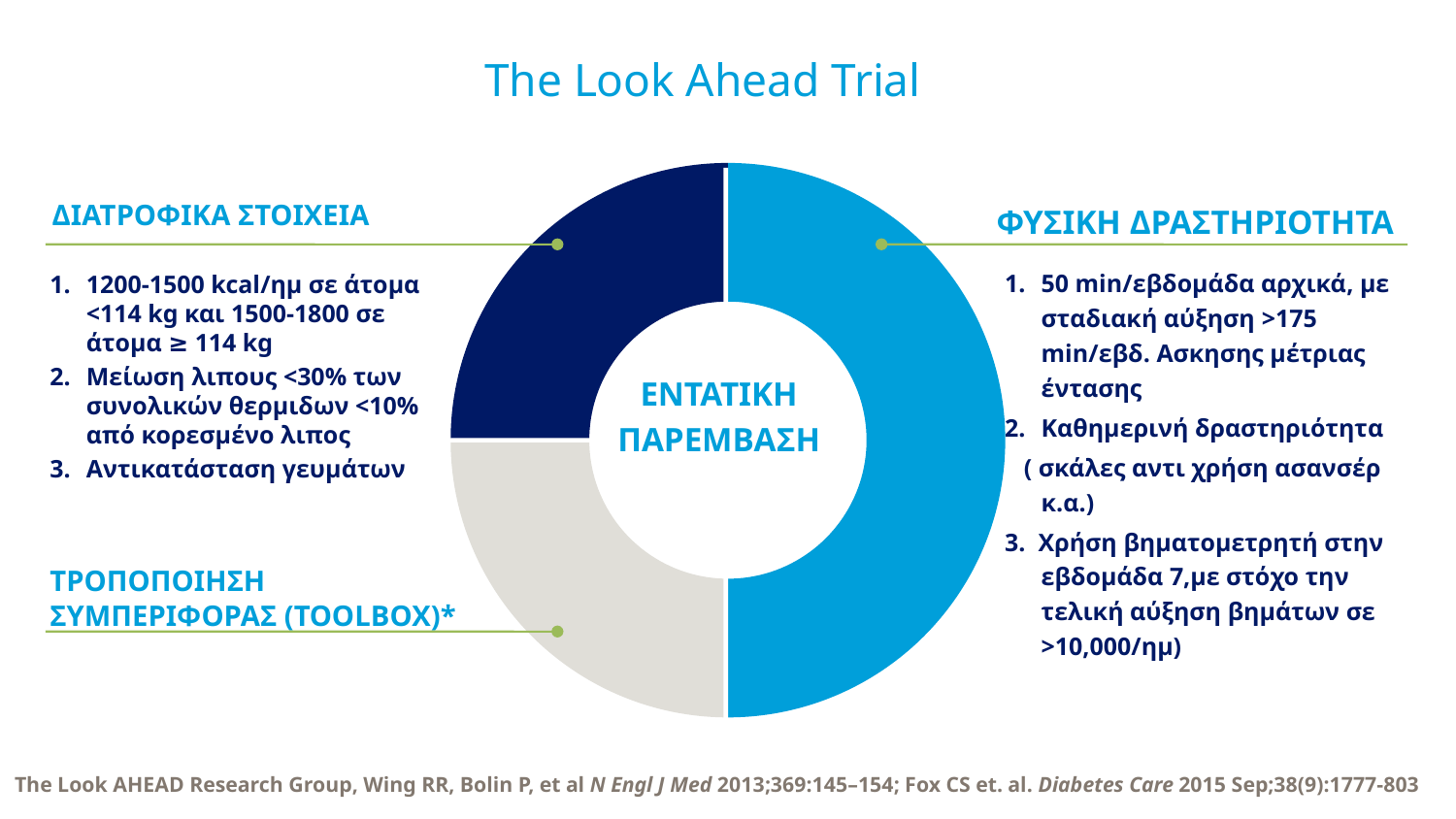
What text is written in the centre of the donut chart? ΕΝΤΑΤΙΚΗ ΠΑΡΕΜΒΑΣΗ What kind of chart is shown in the centre of the slide? Donut chart How many segments does the donut chart have? 3 Which is larger in the donut chart: the ΦΥΣΙΚΗ ΔΡΑΣΤΗΡΙΟΤΗΤΑ segment or the ΤΡΟΠΟΠΟΙΗΣΗ ΣΥΜΠΕΡΙΦΟΡΑΣ (TOOLBOX)* segment? ΦΥΣΙΚΗ ΔΡΑΣΤΗΡΙΟΤΗΤΑ Which segment of the donut chart is the largest? ΦΥΣΙΚΗ ΔΡΑΣΤΗΡΙΟΤΗΤΑ Which is larger in the donut chart: the ΦΥΣΙΚΗ ΔΡΑΣΤΗΡΙΟΤΗΤΑ segment or the ΔΙΑΤΡΟΦΙΚΑ ΣΤΟΙΧΕΙΑ segment? ΦΥΣΙΚΗ ΔΡΑΣΤΗΡΙΟΤΗΤΑ What colour is the ΦΥΣΙΚΗ ΔΡΑΣΤΗΡΙΟΤΗΤΑ segment of the donut chart? Light blue